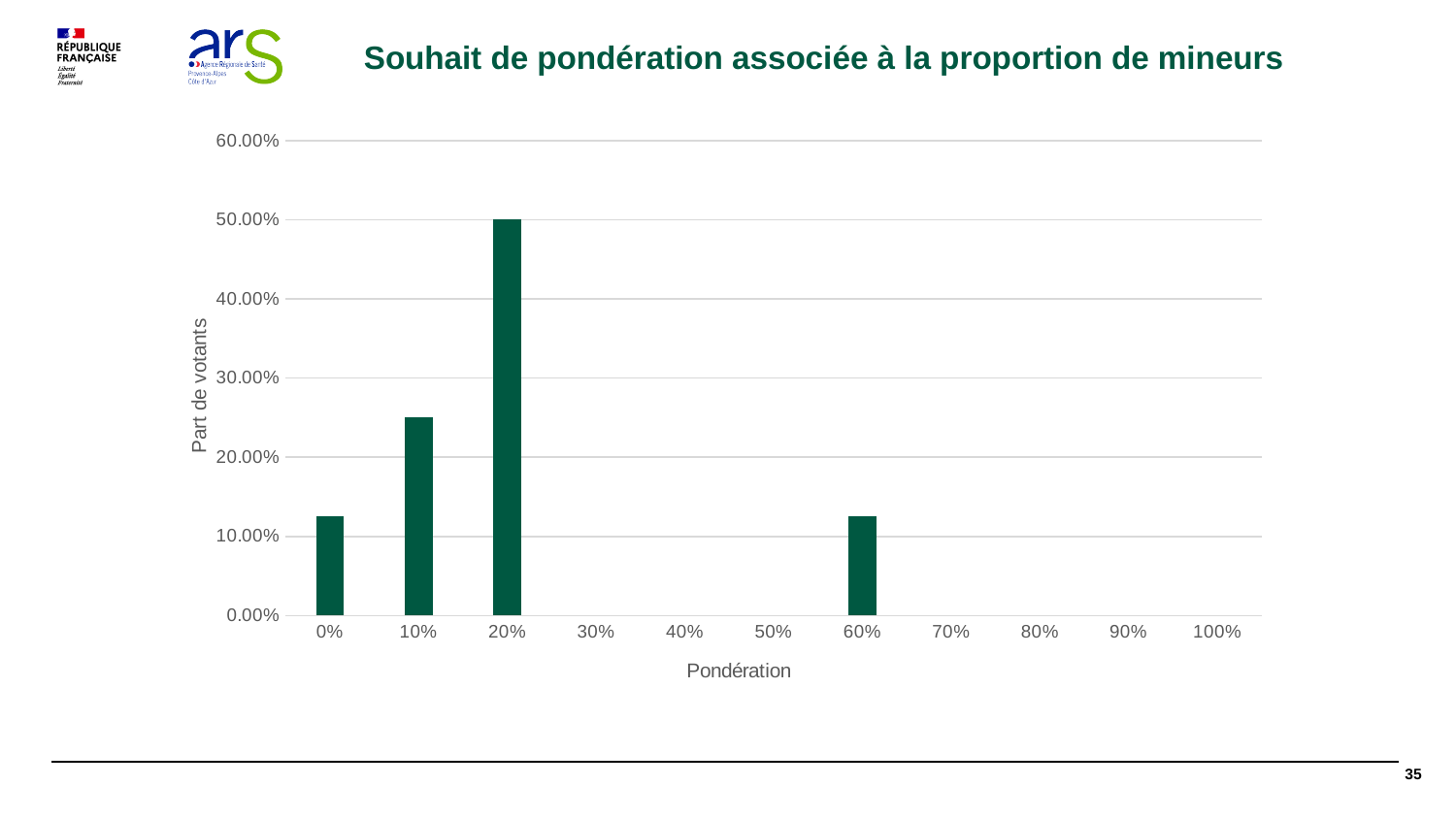
Which pondération category has the highest share of voters? 20% What is the label of the y axis? Part de votants What kind of chart is shown on the slide? bar chart How many categories are shown on the x axis? 11 Which is larger, the value for the 10% pondération category or the value for the 60% pondération category? 10% Which is larger, the value for the 20% pondération category or the value for the 0% pondération category? 20% Is the value for the 0% pondération category greater or less than 10.00%? greater Is the value for the 10% pondération category greater or less than 30.00%? less What is the title of the chart? Souhait de pondération associée à la proportion de mineurs Is the value for the 60% pondération category greater or less than 20.00%? less What is the value for the 20% pondération category? 50.00%